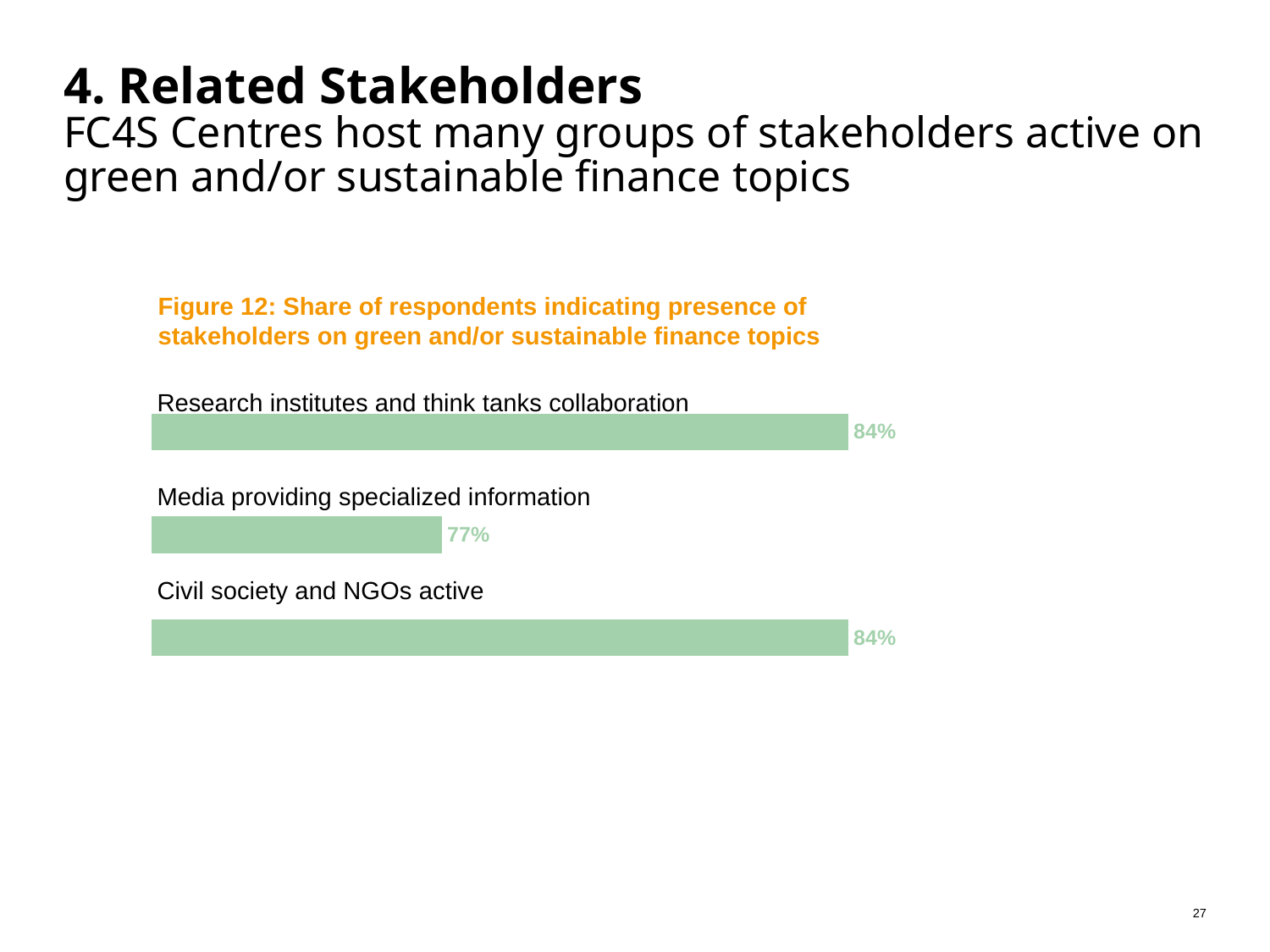
Do research institutes and think tanks collaboration and civil society and NGOs active have the same share of respondents? Yes Which category has the lowest share of respondents? Media providing specialized information How many categories are shown in the chart? 3 What share of respondents indicated the presence of civil society and NGOs active? 84% Which is larger: the share for civil society and NGOs active or the share for media providing specialized information? Civil society and NGOs active What kind of chart is shown on the slide? Bar chart What share of respondents indicated the presence of media providing specialized information? 77% What share of respondents indicated the presence of research institutes and think tanks collaboration? 84% What is the difference between the share for research institutes and think tanks collaboration and the share for media providing specialized information? 7% What is the figure number of the chart on the slide? Figure 12 What colour are the bars in the chart? Green